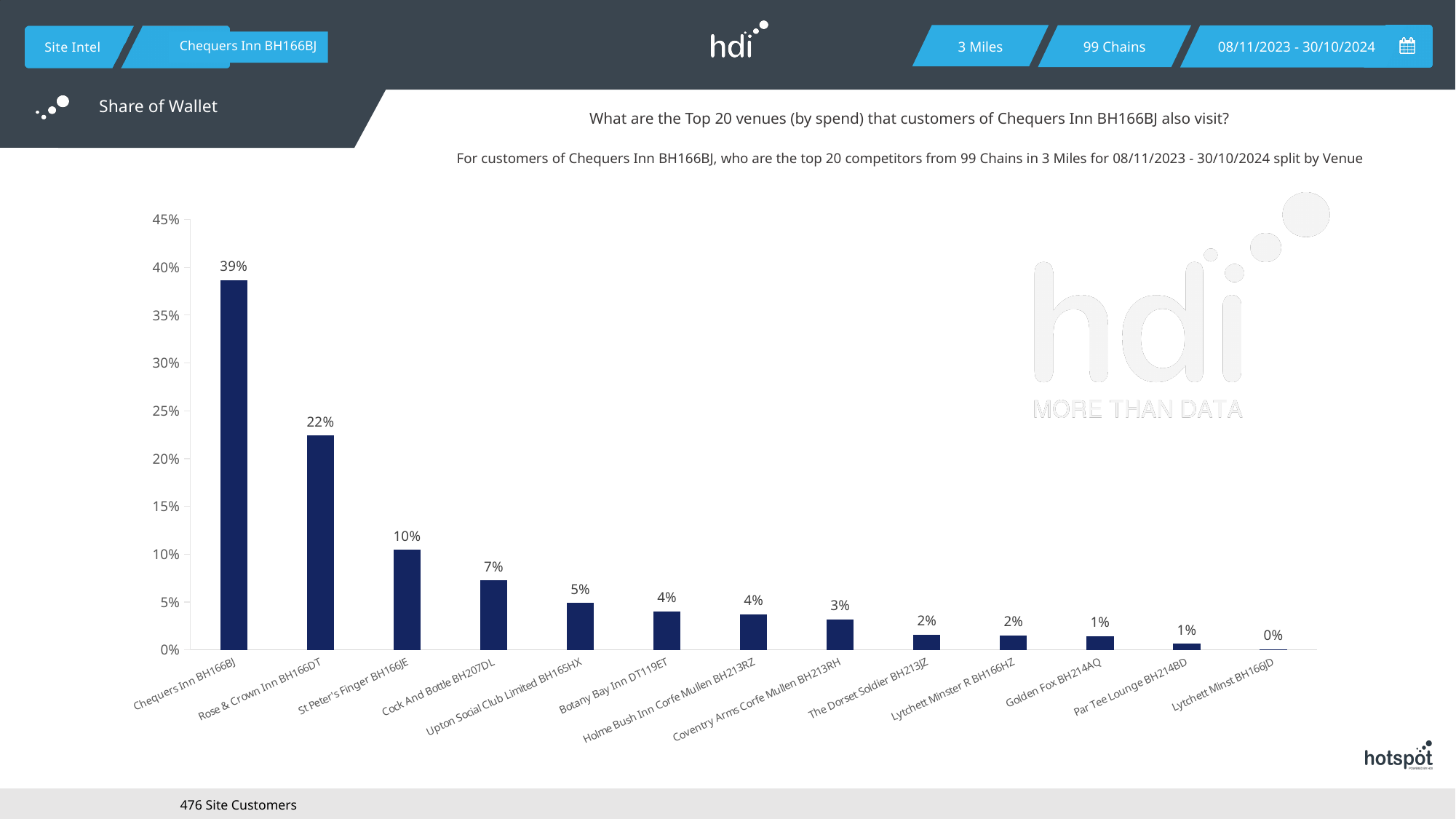
What is the value for Chequers Inn BH166BJ? 39% Do the values rise or fall from left to right along the x axis? fall Which venue has the highest value? Chequers Inn BH166BJ Which venue has the lowest value? Lytchett Minst BH166JD What is the difference between the values for Chequers Inn BH166BJ and Rose & Crown Inn BH166DT? 17% What is the value for Rose & Crown Inn BH166DT? 22% What kind of chart is shown on the slide? bar chart What is the value for Cock And Bottle BH207DL? 7% What is the value for Coventry Arms Corfe Mullen BH213RH? 3% How many venues are shown on the chart? 13 Which is larger, the value for St Peter's Finger BH166JE or the value for Upton Social Club Limited BH165HX? St Peter's Finger BH166JE Is the value for Rose & Crown Inn BH166DT greater or less than 20%? greater